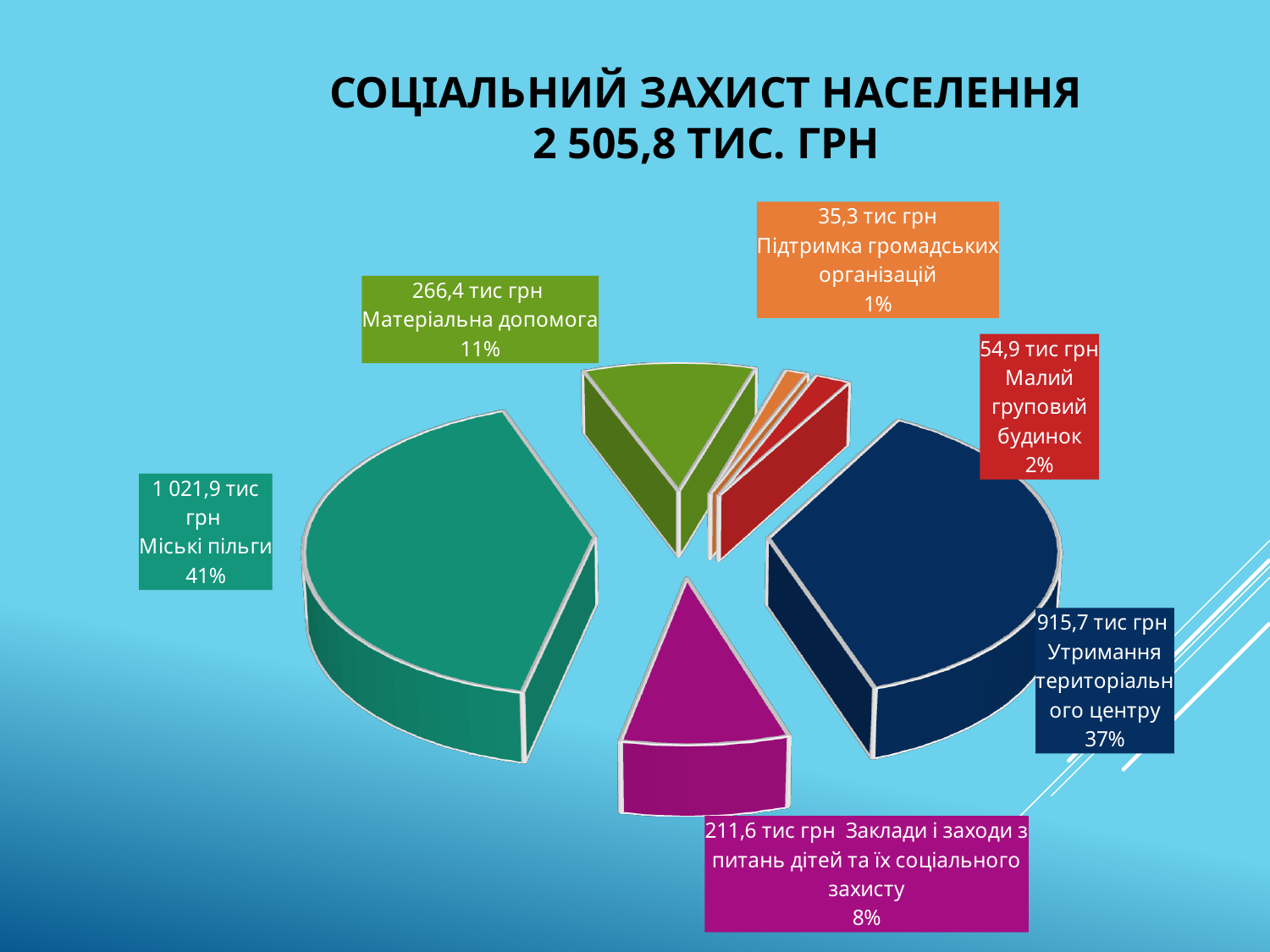
What share of the pie does Заклади і заходи з питань дітей та їх соціального захисту represent? 8% How many slices does the pie chart have? 6 Which is larger, the value for Малий груповий будинок or Підтримка громадських організацій? Малий груповий будинок What kind of chart is shown on the slide? Pie chart Which category has the smallest slice of the pie? Підтримка громадських організацій What is the difference between the values for Міські пільги and Утримання територіального центру? 106,2 тис грн Which category has the largest slice of the pie? Міські пільги What total amount is stated in the chart title? 2 505,8 тис. грн What is the value for Утримання територіального центру? 915,7 тис грн What is the value for Міські пільги? 1 021,9 тис грн What is the value for Підтримка громадських організацій? 35,3 тис грн What share of the pie does Матеріальна допомога represent? 11%